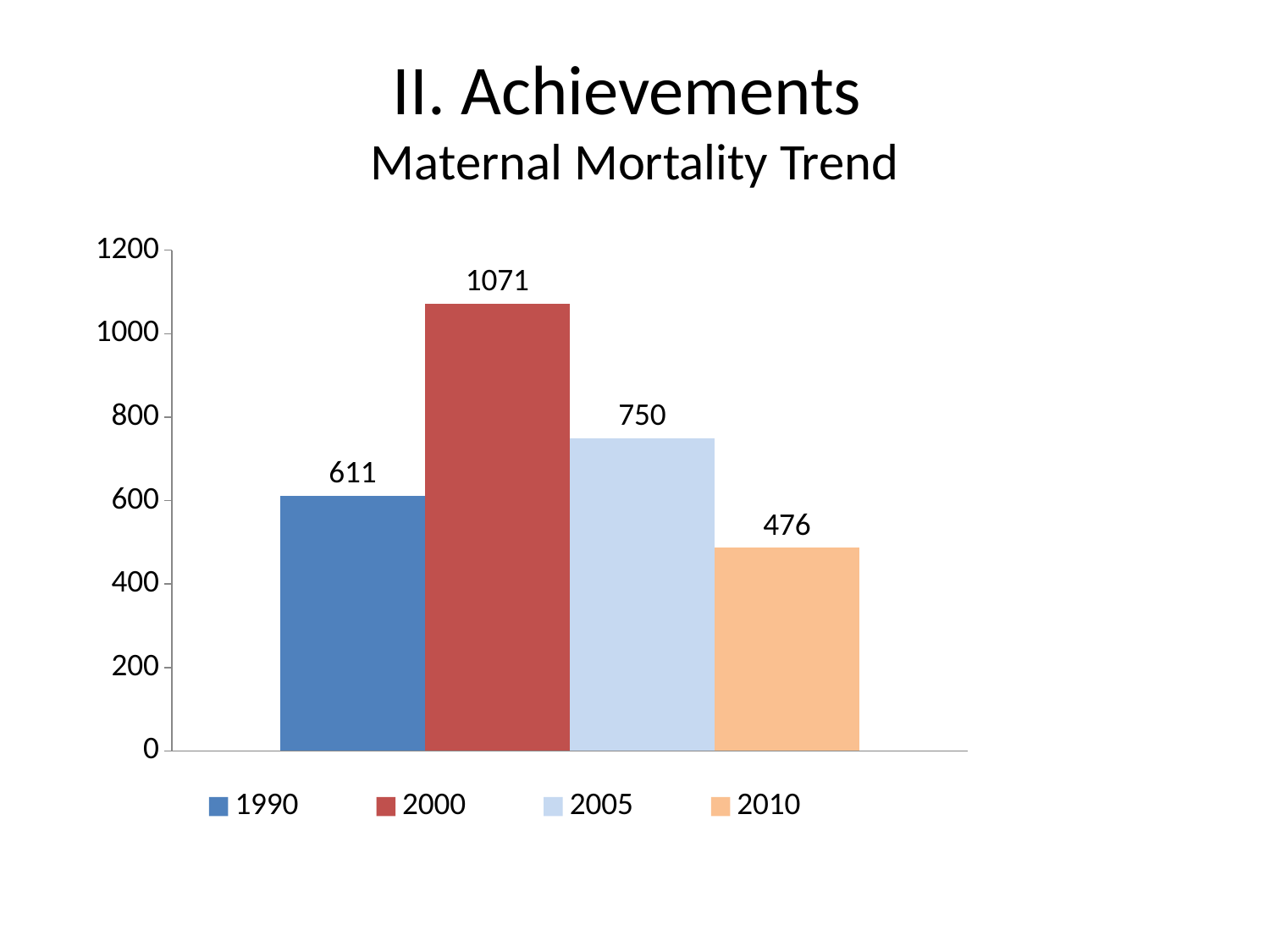
What is the maternal mortality value for 2010? 476 What is the maternal mortality value for 1990? 611 What is the difference between the values for 2005 and 1990? 139 Which year has the highest maternal mortality value? 2000 Which year has the lowest maternal mortality value? 2010 How many entries does the legend list? 4 What kind of chart is shown on the slide? Bar chart What is the maternal mortality value for 2005? 750 Which is larger, the value for 1990 or the value for 2005? 2005 How many bars are shown in the chart? 4 What is the maternal mortality value for 2000? 1071 What is the difference between the values for 2000 and 2010? 595